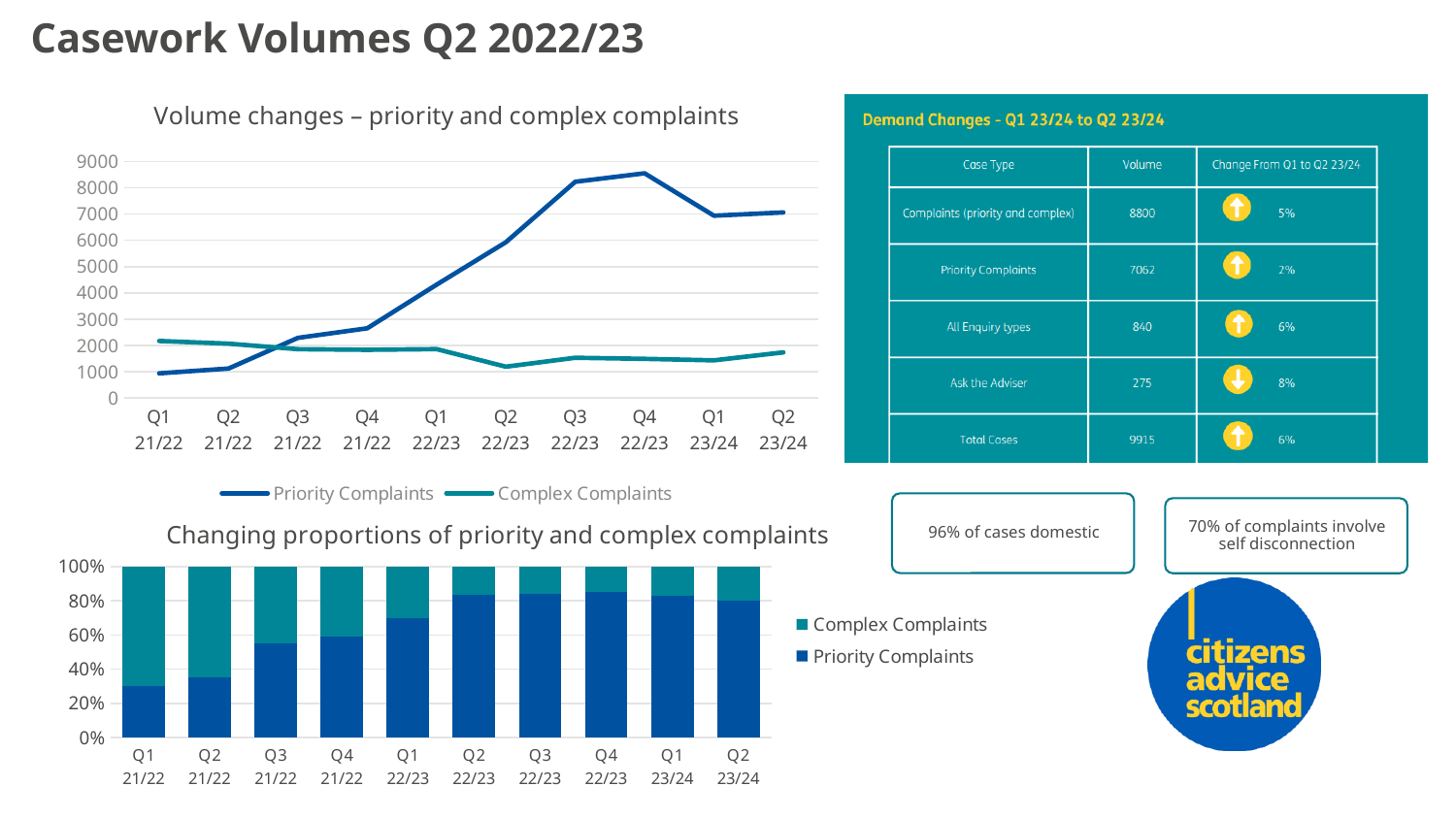
In the 'Volume changes – priority and complex complaints' chart, do Priority Complaints rise or fall from Q1 21/22 to Q4 22/23? Rise In the 'Volume changes – priority and complex complaints' chart, which series has the higher value in Q1 21/22? Complex Complaints What kind of chart is 'Volume changes – priority and complex complaints'? Line chart In the 'Volume changes – priority and complex complaints' chart, how many quarters are plotted on the x axis? 10 In the 'Volume changes – priority and complex complaints' chart, how many series does the legend list? 2 What kind of chart is 'Changing proportions of priority and complex complaints'? Stacked bar chart In the 'Changing proportions of priority and complex complaints' chart, which quarter has the smallest share of Priority Complaints? Q1 21/22 In the 'Volume changes – priority and complex complaints' chart, in which quarter do Priority Complaints reach their highest value? Q4 22/23 In the 'Volume changes – priority and complex complaints' chart, in which quarter are Priority Complaints lowest? Q1 21/22 In the 'Changing proportions of priority and complex complaints' chart, is the Priority Complaints share in Q4 22/23 greater or less than 80%? greater In the 'Volume changes – priority and complex complaints' chart, is the value for Complex Complaints in Q2 22/23 greater or less than 2000? less In the 'Volume changes – priority and complex complaints' chart, is the value for Priority Complaints in Q4 22/23 greater or less than 8000? greater